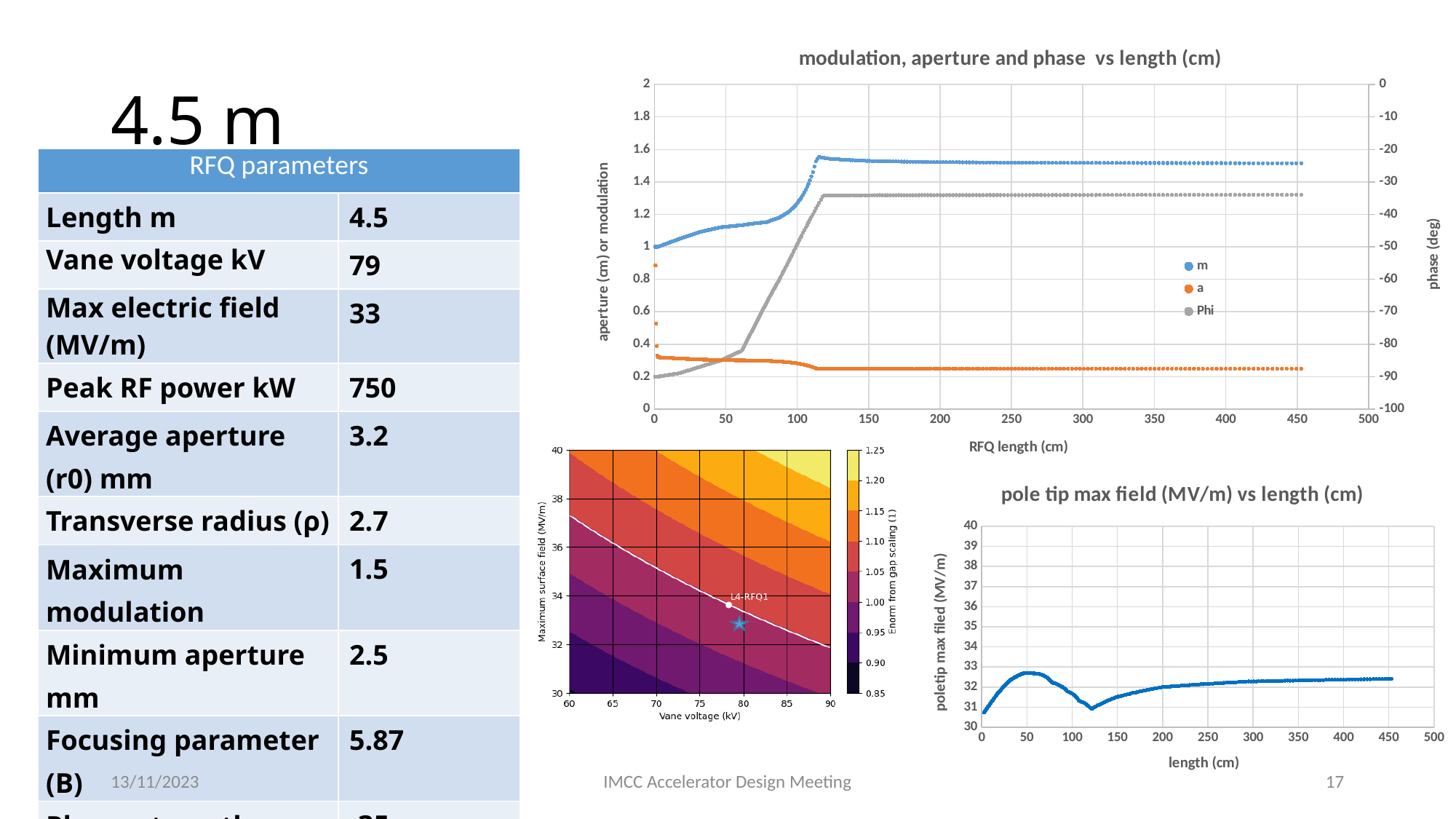
In the chart titled 'pole tip max field (MV/m) vs length (cm)', is the value at 450 cm greater or less than 33? less In the chart titled 'modulation, aperture and phase vs length (cm)', is the value of the m series at 450 cm greater or less than 1.4? greater In the chart titled 'modulation, aperture and phase vs length (cm)', how many series does the legend list? 3 In the chart titled 'modulation, aperture and phase vs length (cm)', what are the names of the series in the legend? m, a, Phi In the chart titled 'modulation, aperture and phase vs length (cm)', is the value of the m series at 0 cm greater or less than 1.2? less In the chart titled 'modulation, aperture and phase vs length (cm)', does the a series generally rise or fall as RFQ length increases from 0 to 150 cm? fall In the chart titled 'modulation, aperture and phase vs length (cm)', does the m series rise or fall between 0 and 120 cm? rise In the chart titled 'pole tip max field (MV/m) vs length (cm)', does the value rise or fall between 150 cm and 450 cm? rise What is the x-axis label of the contour plot at the bottom middle of the slide? Vane voltage (kV)